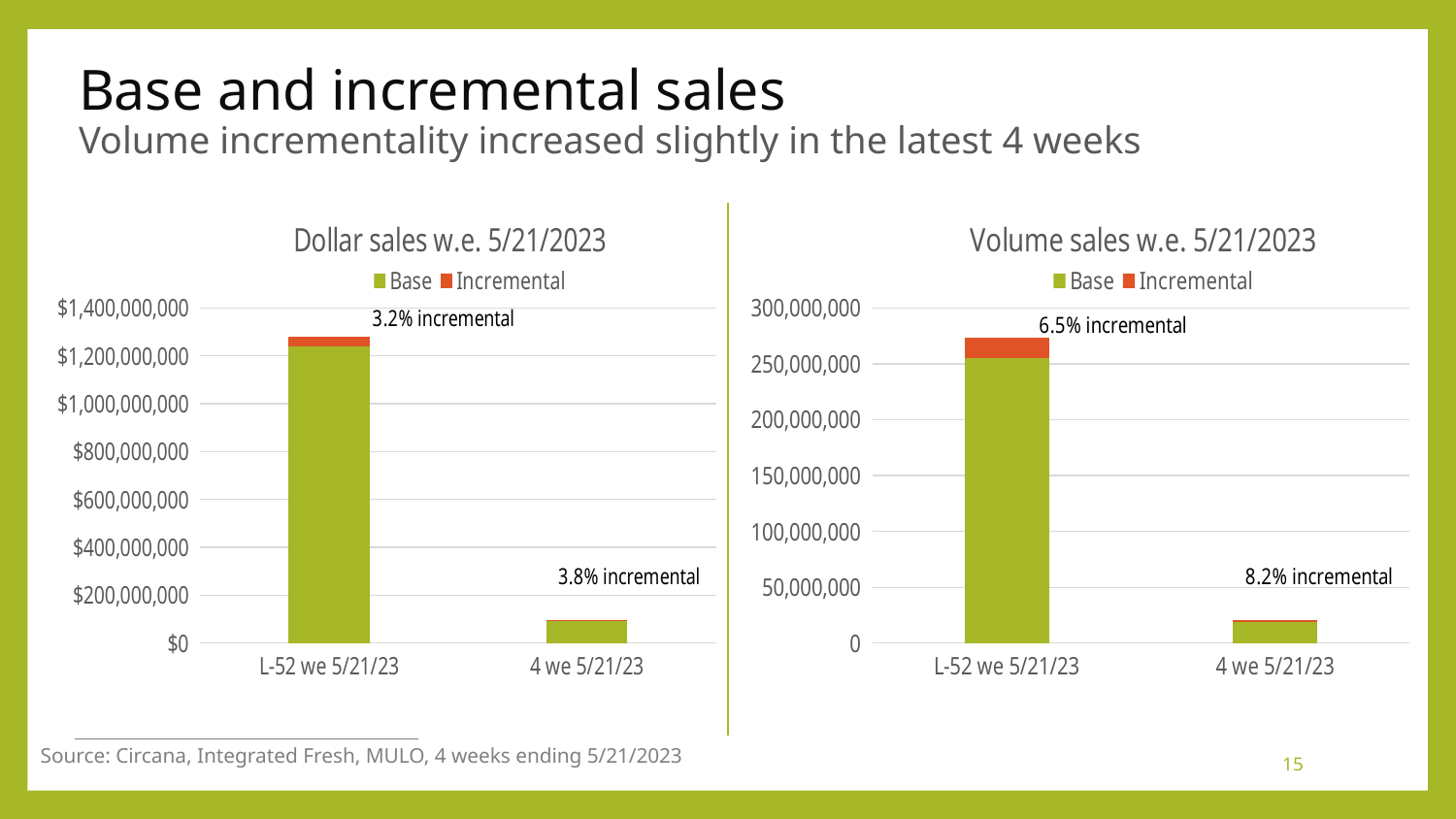
In the Dollar sales w.e. 5/21/2023 chart, what incremental percentage is labelled for 4 we 5/21/23? 3.8% incremental In the Volume sales w.e. 5/21/2023 chart, what incremental percentage is labelled for 4 we 5/21/23? 8.2% incremental In the Dollar sales w.e. 5/21/2023 chart, is the total bar for L-52 we 5/21/23 greater or less than $1,200,000,000? greater How many categories are shown on the x axis of the Volume sales w.e. 5/21/2023 chart? 2 In the Volume sales w.e. 5/21/2023 chart, which period has the taller bar, L-52 we 5/21/23 or 4 we 5/21/23? L-52 we 5/21/23 How many series does the legend of the Dollar sales w.e. 5/21/2023 chart list? 2 In the Volume sales w.e. 5/21/2023 chart, what incremental percentage is labelled for L-52 we 5/21/23? 6.5% incremental What kind of chart is the Dollar sales w.e. 5/21/2023 chart? Stacked bar chart In the Volume sales w.e. 5/21/2023 chart, is the total bar for L-52 we 5/21/23 greater or less than 250,000,000? greater In the Volume sales w.e. 5/21/2023 chart, is the total bar for 4 we 5/21/23 greater or less than 50,000,000? less In the Dollar sales w.e. 5/21/2023 chart, what incremental percentage is labelled for L-52 we 5/21/23? 3.2% incremental